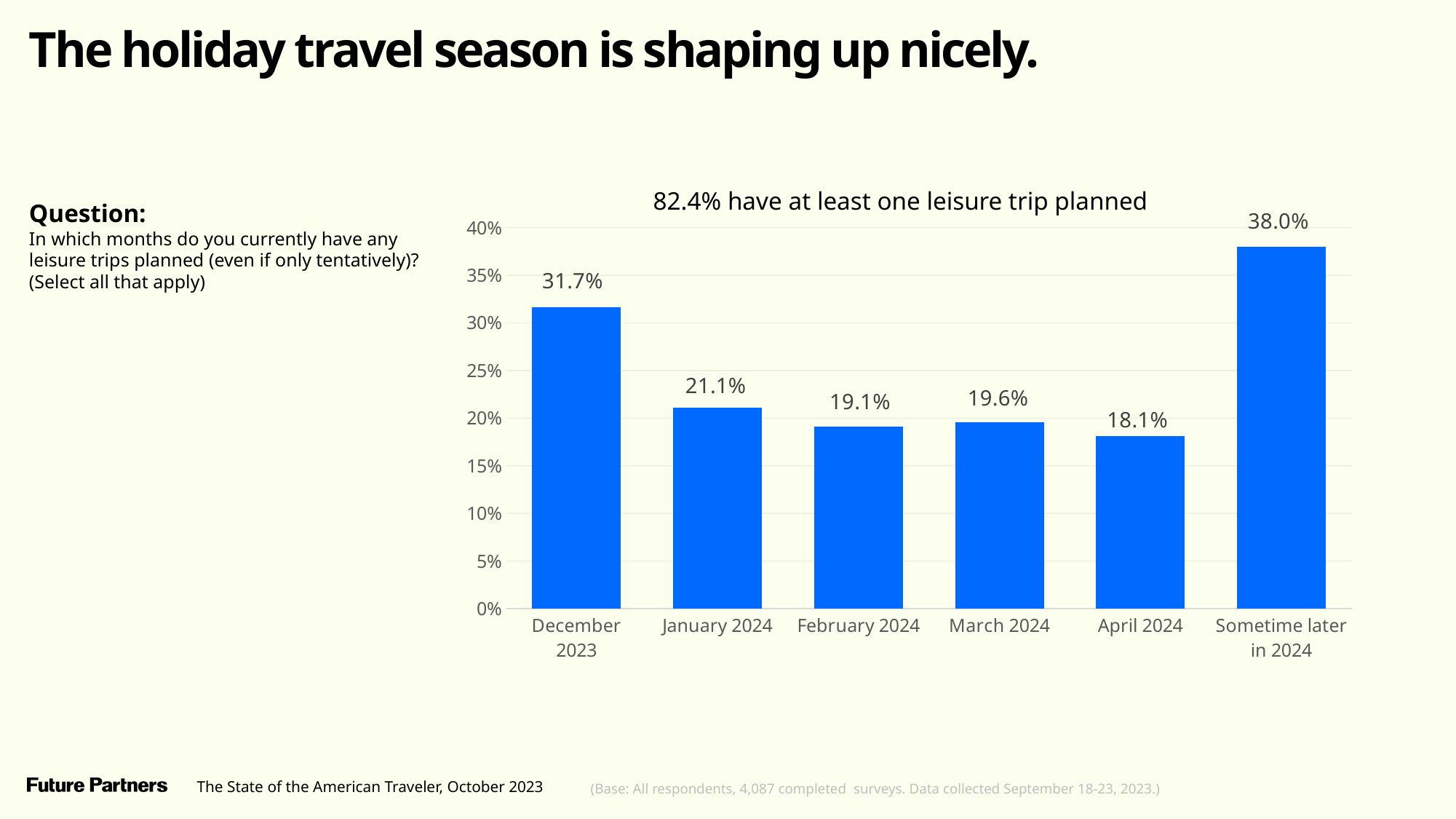
What percentage of respondents have a leisure trip planned for December 2023? 31.7% How many categories are shown on the x axis? 6 Which category has the lowest value? April 2024 What colour are the bars in the chart? blue What is the difference between the values for December 2023 and January 2024? 10.6% What is the value shown for February 2024? 19.1% What is the title of the chart? 82.4% have at least one leisure trip planned Which category has the highest value? Sometime later in 2024 What is the value shown for Sometime later in 2024? 38.0% What kind of chart is shown on the slide? bar chart Which is larger, the value for March 2024 or the value for April 2024? March 2024 Is the value for January 2024 greater or less than 20%? greater